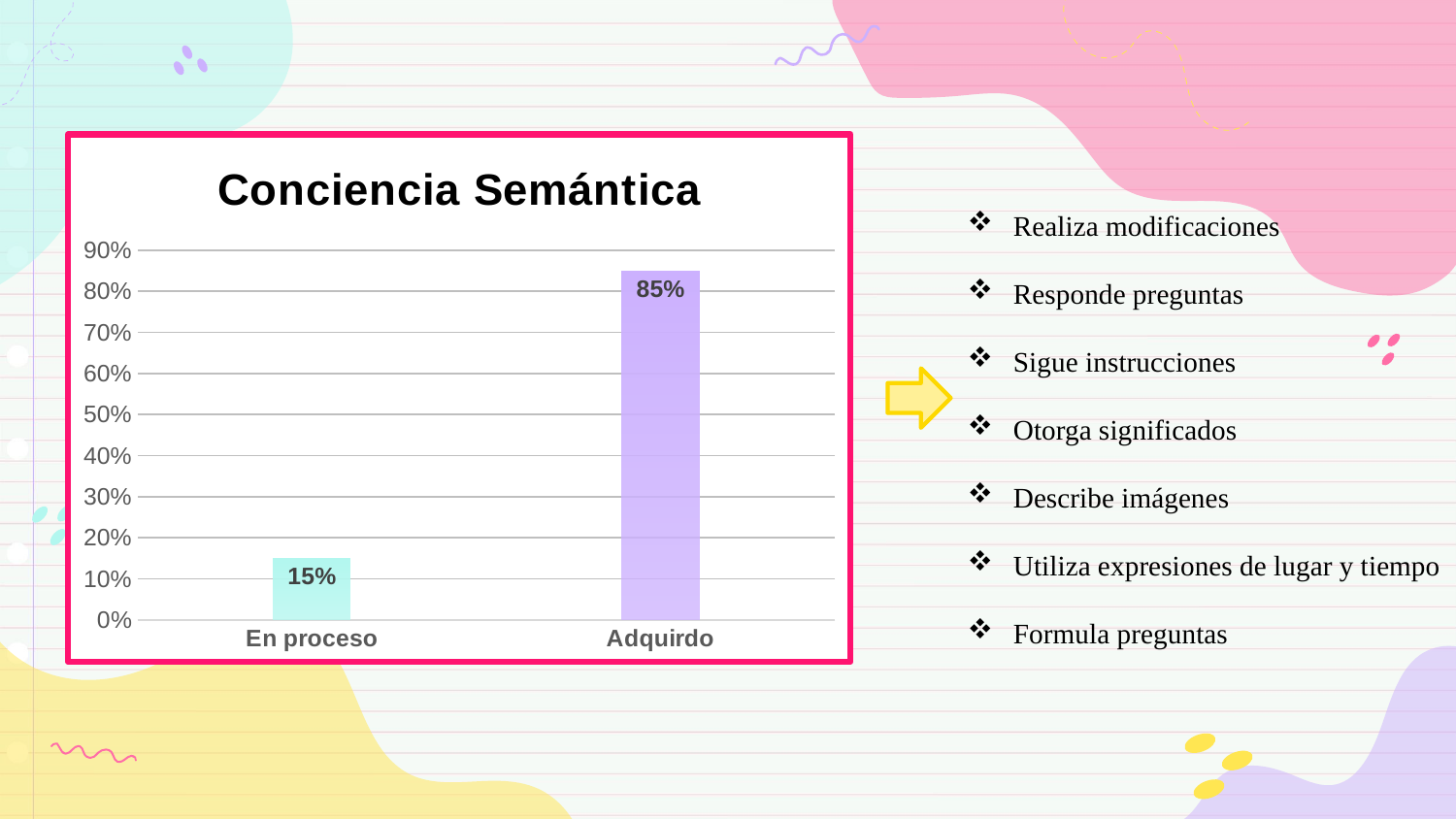
What is the title of the chart? Conciencia Semántica Which category has the lowest value? En proceso What is the highest value shown on the y axis? 90% How many categories are shown on the x axis? 2 Which is larger, the value for En proceso or the value for Adquirdo? Adquirdo Which category has the highest value? Adquirdo What is the value for En proceso? 15% Is the value for Adquirdo greater or less than 80%? greater What kind of chart is shown? bar chart What is the value for Adquirdo? 85% What is the difference between the values for Adquirdo and En proceso? 70% Is the value for En proceso greater or less than 20%? less